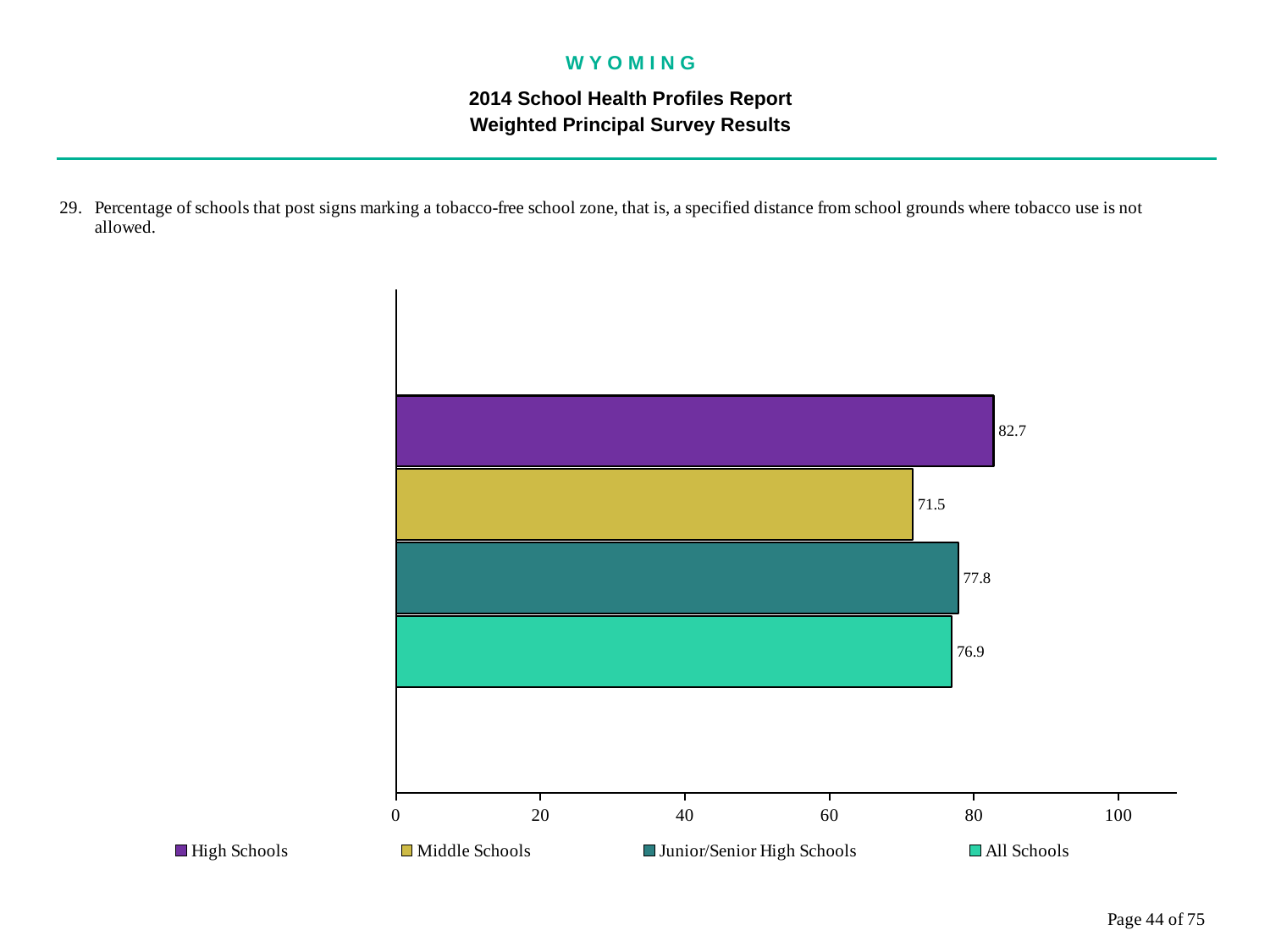
Which is larger, the value for Junior/Senior High Schools or the value for All Schools? Junior/Senior High Schools Which school type has the highest value? High Schools What is the value for Middle Schools? 71.5 What kind of chart is shown on the slide? bar chart What is the value for High Schools? 82.7 What is the value for Junior/Senior High Schools? 77.8 Is the value for High Schools greater or less than 80? greater What is the value for All Schools? 76.9 How many bars are plotted in the chart? 4 Which school type has the lowest value? Middle Schools How many entries does the legend list? 4 What is the difference between the High Schools value and the Middle Schools value? 11.2